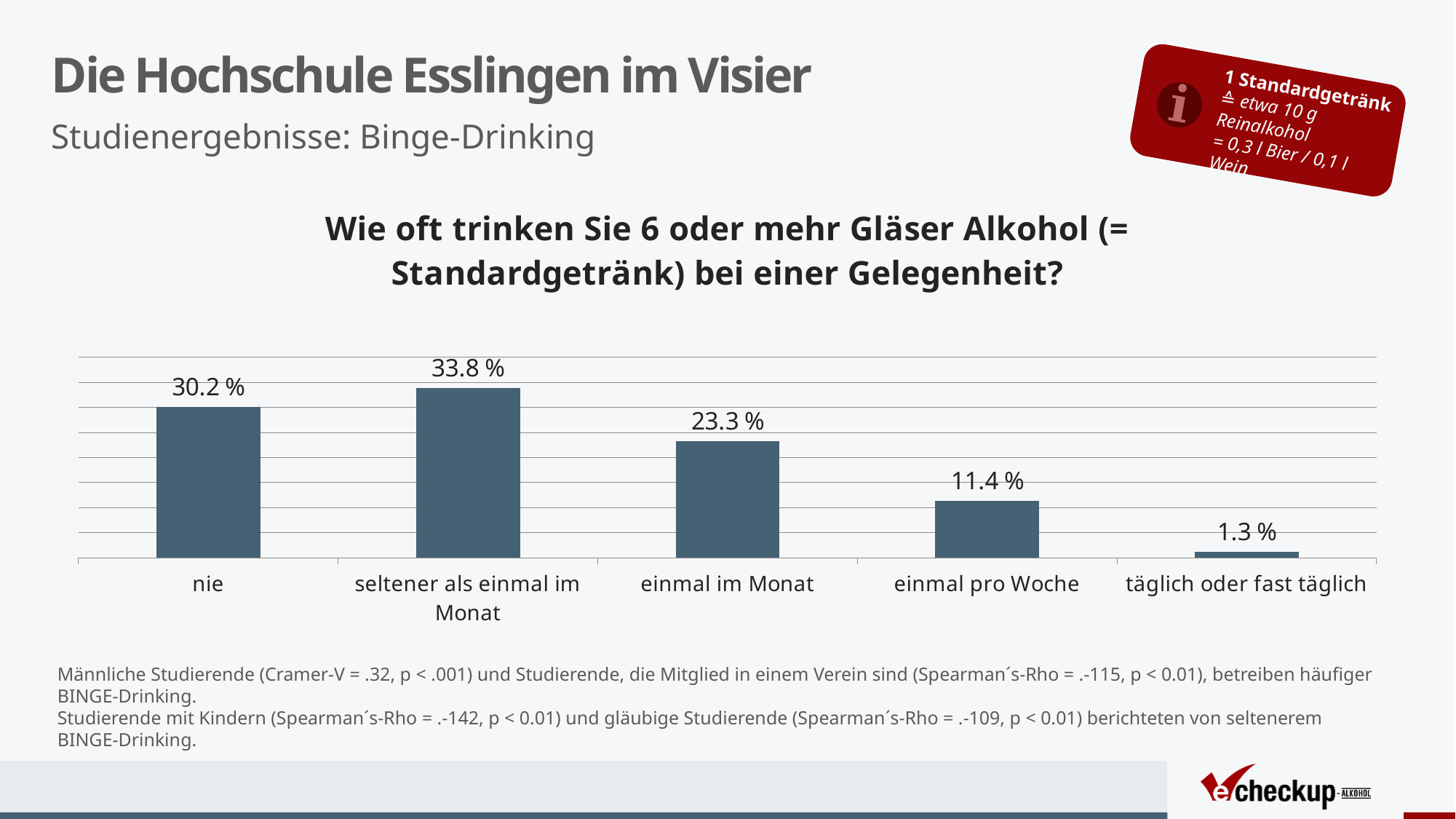
What is the difference between the values for "seltener als einmal im Monat" and "nie"? 3.6 % Which category has the highest value? seltener als einmal im Monat What is the title of the chart? Wie oft trinken Sie 6 oder mehr Gläser Alkohol (= Standardgetränk) bei einer Gelegenheit? Which category has the lowest value? täglich oder fast täglich Which is larger, the value for "einmal im Monat" or the value for "einmal pro Woche"? einmal im Monat What is the value for "seltener als einmal im Monat"? 33.8 % How many categories are shown in the chart? 5 What is the value for "einmal im Monat"? 23.3 % What is the value for "täglich oder fast täglich"? 1.3 % What is the value for "einmal pro Woche"? 11.4 % What kind of chart is shown on the slide? bar chart What is the value for "nie"? 30.2 %